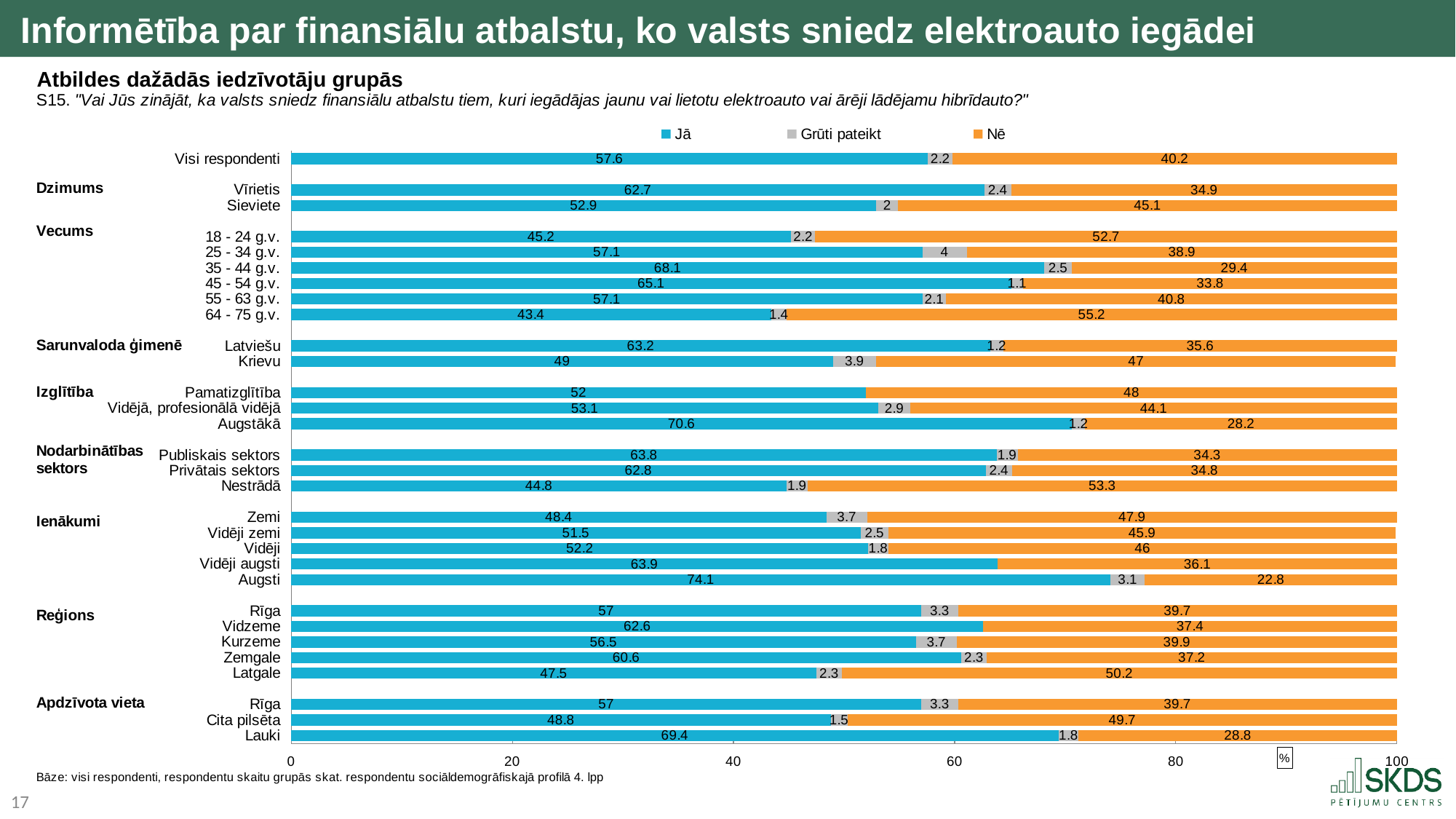
Which has a larger "Nē" value, Latviešu or Krievu? Krievu What is the "Jā" value for Lauki? 69.4 What is the "Nē" value for Sieviete? 45.1 Which category has the lowest "Jā" value? 64 - 75 g.v. What is the difference between the "Jā" values for Vīrietis and Sieviete? 9.8 What is the total of the "Jā" and "Nē" values for Augstākā? 98.8 Which legend entry is shown in orange? Nē What is the "Jā" value for Visi respondenti? 57.6 What kind of chart is shown on the slide? Stacked bar chart What is the "Grūti pateikt" value for 25 - 34 g.v.? 4 Which category has the highest "Jā" value? Augsti How many series does the legend list? 3